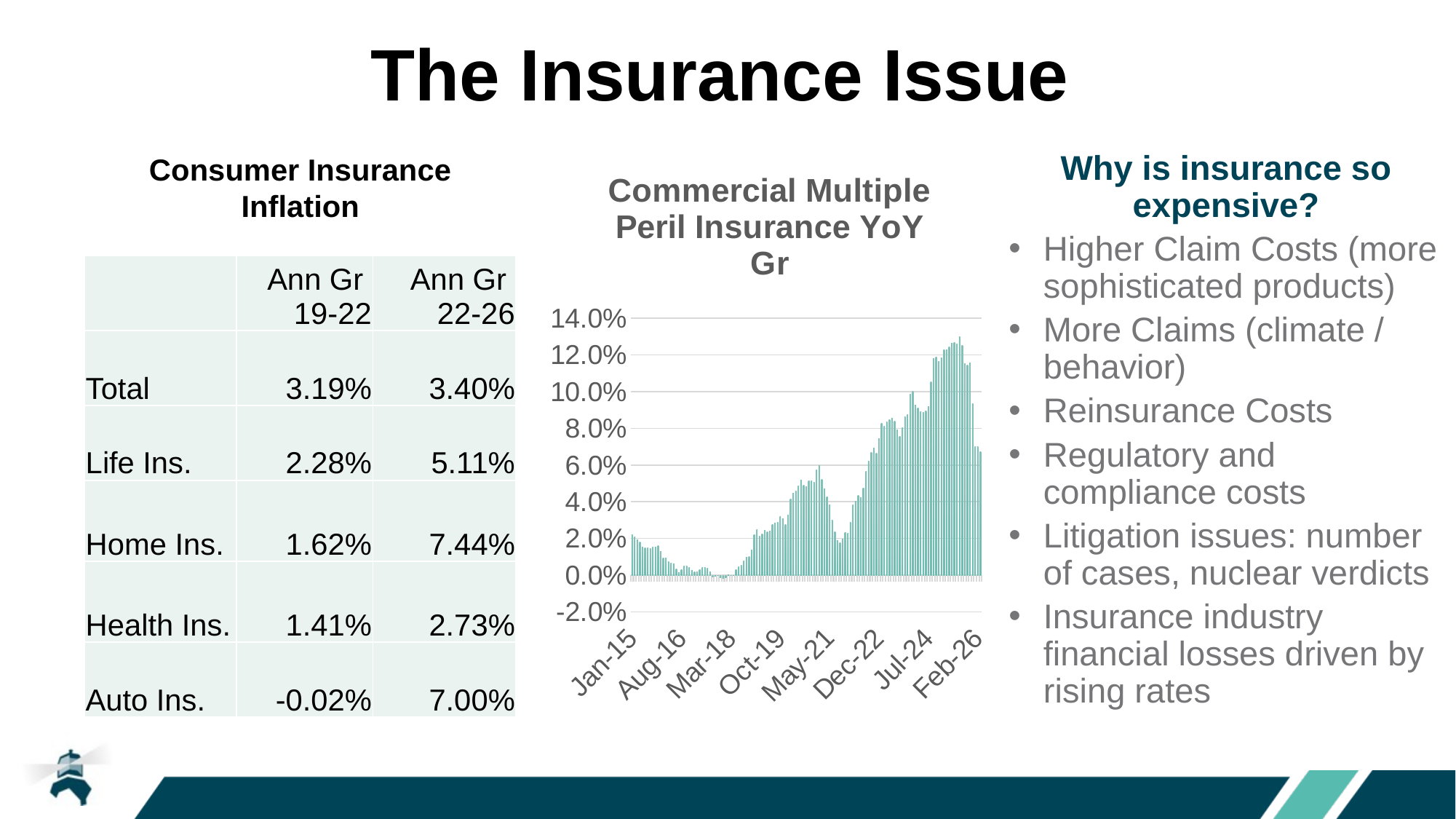
In the Commercial Multiple Peril Insurance YoY Gr chart, is the value at Jan-15 greater or less than 4.0%? less In the Commercial Multiple Peril Insurance YoY Gr chart, do the values rise or fall between Mar-18 and Oct-19? rise In the Commercial Multiple Peril Insurance YoY Gr chart, is the last bar at Feb-26 greater or less than 4.0%? greater In the Commercial Multiple Peril Insurance YoY Gr chart, is the value around Jul-24 greater or less than 6.0%? greater What is the title of the chart on the slide? Commercial Multiple Peril Insurance YoY Gr What colour are the bars in the Commercial Multiple Peril Insurance YoY Gr chart? teal In the Commercial Multiple Peril Insurance YoY Gr chart, is the overall trend from Jan-15 to Feb-26 rising or falling? rising How many date labels are shown on the x axis of the Commercial Multiple Peril Insurance YoY Gr chart? 8 In the Commercial Multiple Peril Insurance YoY Gr chart, do the values rise or fall between Jan-15 and Mar-18? fall What kind of chart is the Commercial Multiple Peril Insurance YoY Gr chart? bar chart